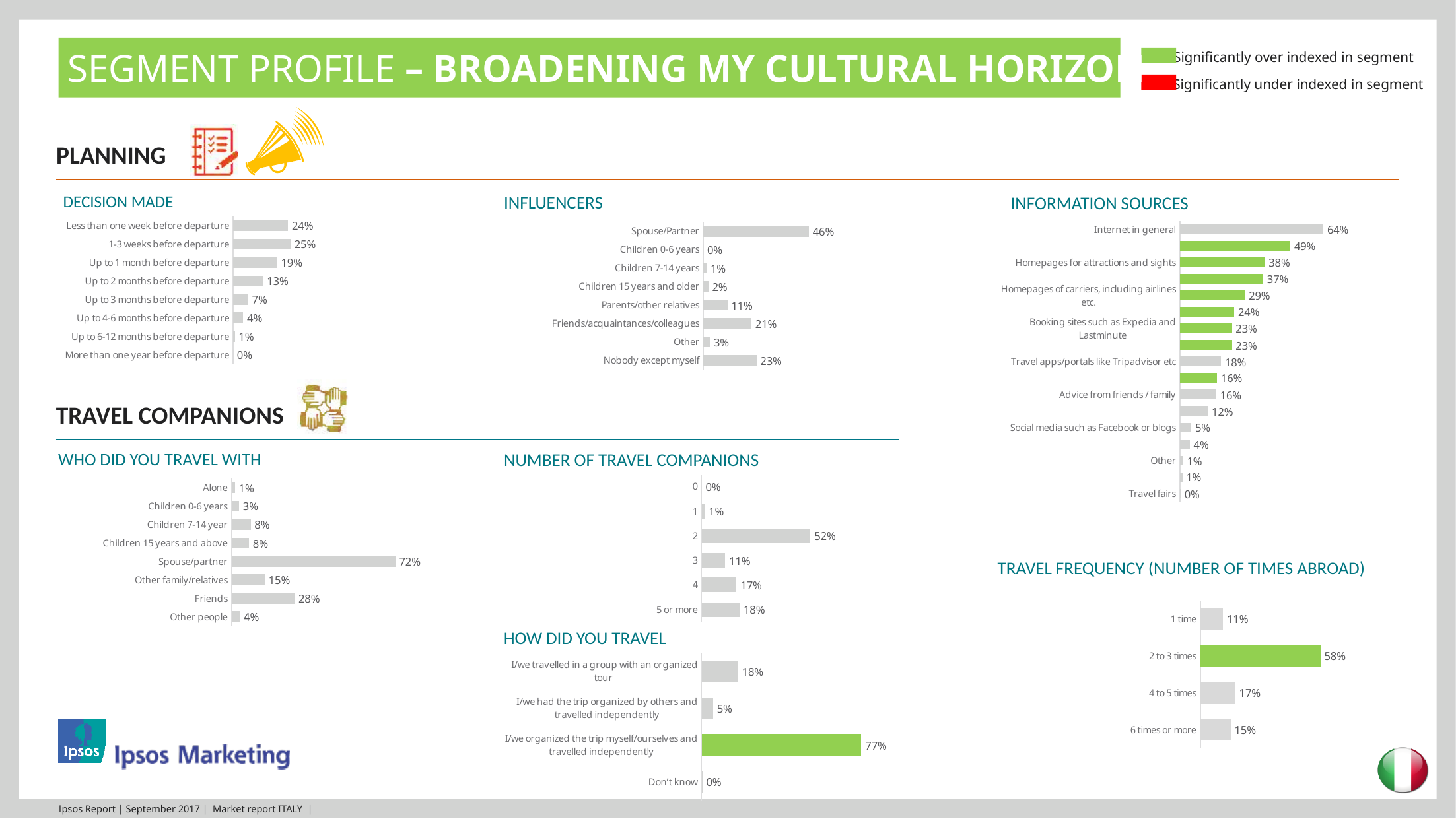
In the Number of Travel Companions chart, what is the value for 2? 52% In the Travel Frequency (Number of Times Abroad) chart, what is the difference between 2 to 3 times and 4 to 5 times? 41% In the Influencers chart, what is the value for Spouse/Partner? 46% In the Information Sources chart, which category has the highest value? Internet in general In the Who Did You Travel With chart, which is larger, Friends or Other family/relatives? Friends In the Decision Made chart, what is the value for 1-3 weeks before departure? 25% What type of chart is the Travel Frequency (Number of Times Abroad) chart? Bar chart In the How Did You Travel chart, what is the value for 'I/we organized the trip myself/ourselves and travelled independently'? 77% In the Decision Made chart, which category has the lowest value? More than one year before departure In the Influencers chart, what is the difference between Friends/acquaintances/colleagues and Parents/other relatives? 10% How many categories does the Who Did You Travel With chart show? 8 In the Information Sources chart, what is the value for Travel fairs? 0%